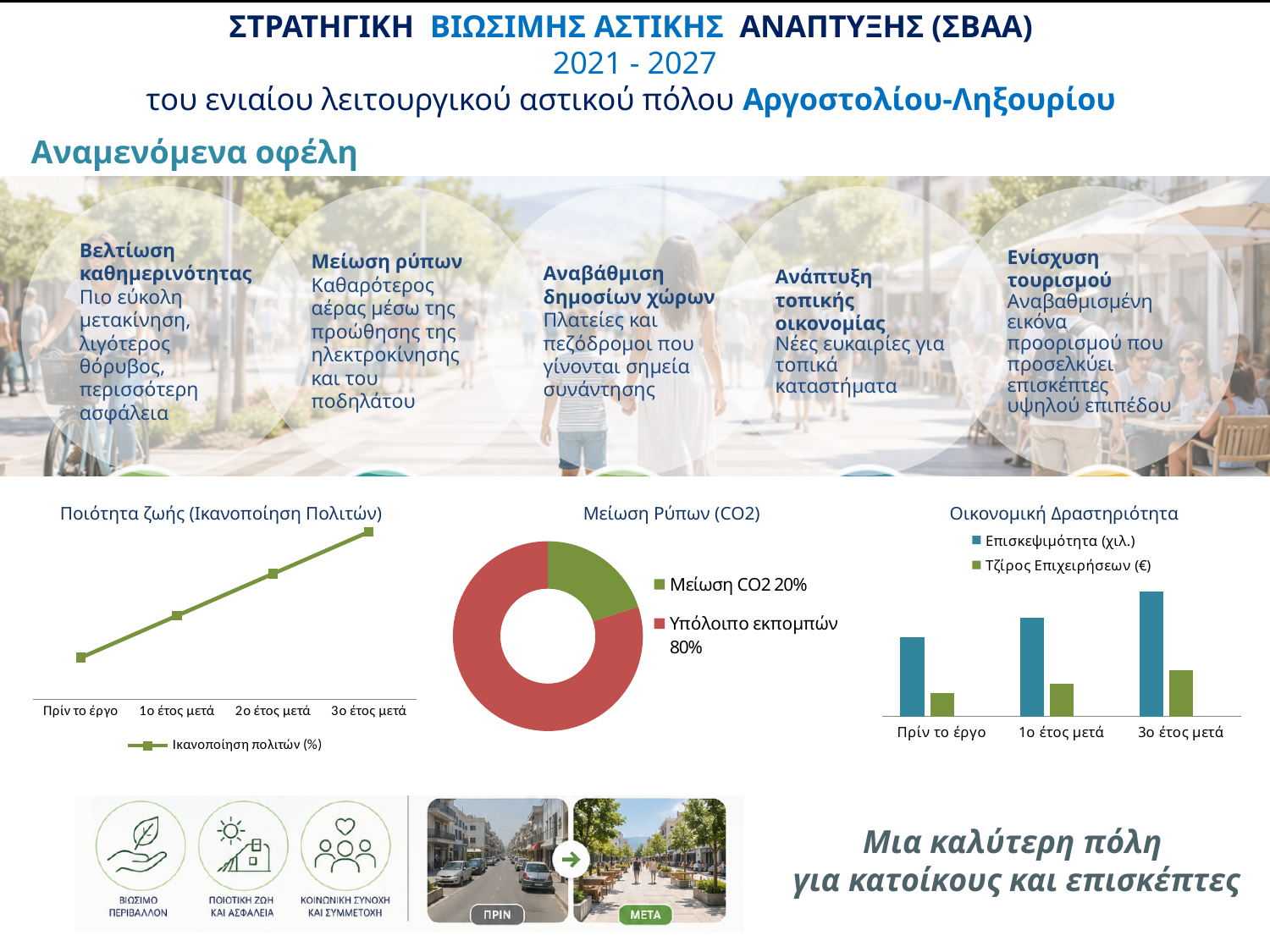
What is the legend entry of the 'Ποιότητα ζωής (Ικανοποίηση Πολιτών)' chart? Ικανοποίηση πολιτών (%) In the 'Μείωση Ρύπων (CO2)' chart, what share does 'Υπόλοιπο εκπομπών' represent? 80% In the 'Ποιότητα ζωής (Ικανοποίηση Πολιτών)' chart, which category has the highest value? 3ο έτος μετά What kind of chart is the 'Οικονομική Δραστηριότητα' chart? bar chart In the 'Οικονομική Δραστηριότητα' chart, for '1ο έτος μετά', which is larger: 'Επισκεψιμότητα (χιλ.)' or 'Τζίρος Επιχειρήσεων (€)'? Επισκεψιμότητα (χιλ.) How many points are plotted in the 'Ποιότητα ζωής (Ικανοποίηση Πολιτών)' chart? 4 What kind of chart is the 'Μείωση Ρύπων (CO2)' chart? donut chart In the 'Ποιότητα ζωής (Ικανοποίηση Πολιτών)' chart, do the values rise or fall from 'Πριν το έργο' to '3ο έτος μετά'? rise In the 'Μείωση Ρύπων (CO2)' chart, what share does 'Μείωση CO2' represent? 20% How many series does the legend of the 'Οικονομική Δραστηριότητα' chart list? 2 In the 'Οικονομική Δραστηριότητα' chart, which category has the highest 'Επισκεψιμότητα (χιλ.)' value? 3ο έτος μετά What kind of chart is the 'Ποιότητα ζωής (Ικανοποίηση Πολιτών)' chart? line chart